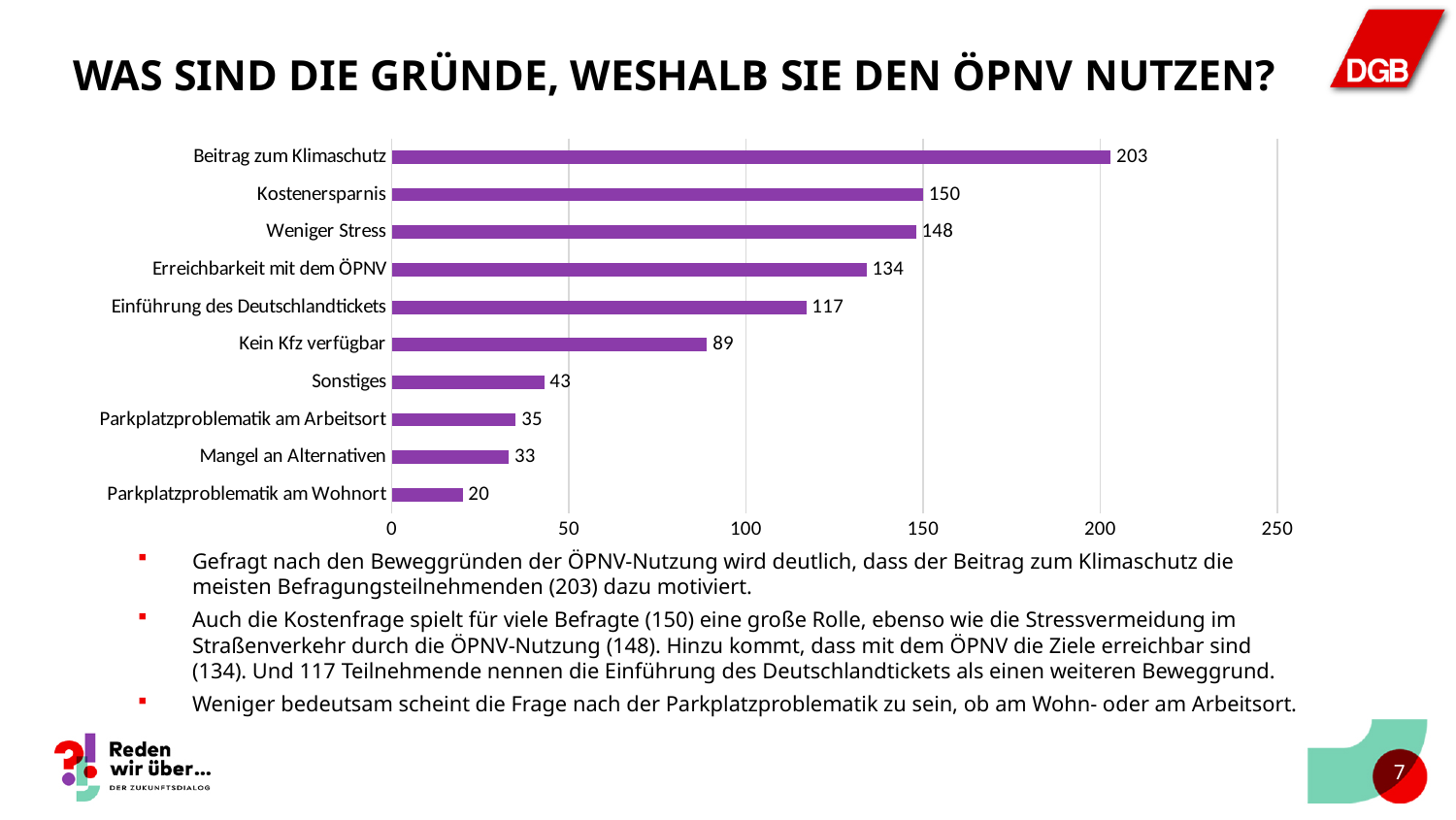
Which is larger, the value for Sonstiges or the value for Mangel an Alternativen? Sonstiges What kind of chart is shown on the slide? bar chart What is the difference between the values for Kostenersparnis and Erreichbarkeit mit dem ÖPNV? 16 How many categories are shown in the chart? 10 What is the value for Beitrag zum Klimaschutz? 203 What is the value for Einführung des Deutschlandtickets? 117 What is the value for Kein Kfz verfügbar? 89 Which category has the lowest value? Parkplatzproblematik am Wohnort Which category has the highest value? Beitrag zum Klimaschutz What is the difference between the values for Beitrag zum Klimaschutz and Parkplatzproblematik am Wohnort? 183 What is the highest value shown on the horizontal axis? 250 Is the value for Weniger Stress greater or less than 100? greater